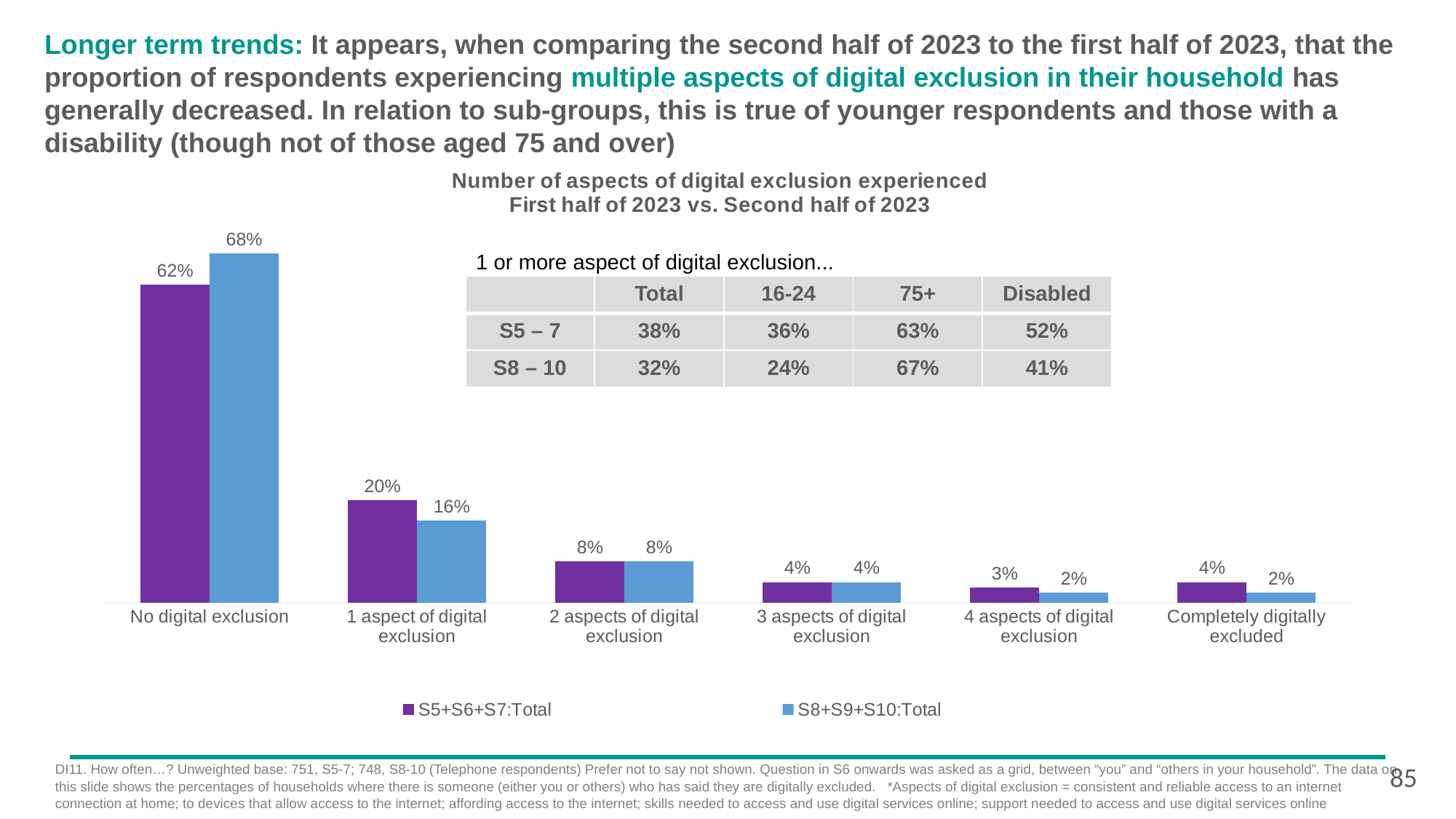
What is the title of the chart? Number of aspects of digital exclusion experienced First half of 2023 vs. Second half of 2023 What type of chart is shown on the slide? Bar chart What is the value for 'Completely digitally excluded' in the S5+S6+S7:Total series? 4% Which category has the highest value in the S5+S6+S7:Total series? No digital exclusion How many categories are shown on the x axis of the bar chart? 6 What is the value for 'No digital exclusion' in the S8+S9+S10:Total series? 68% Which category has the lowest value in the S5+S6+S7:Total series? 4 aspects of digital exclusion What is the value for 'No digital exclusion' in the S5+S6+S7:Total series? 62% What is the value for '1 aspect of digital exclusion' in the S8+S9+S10:Total series? 16% What is the difference between the S8+S9+S10:Total and S5+S6+S7:Total values for 'No digital exclusion'? 6% For '1 aspect of digital exclusion', which series has the larger value, S5+S6+S7:Total or S8+S9+S10:Total? S5+S6+S7:Total How many series does the legend list? 2